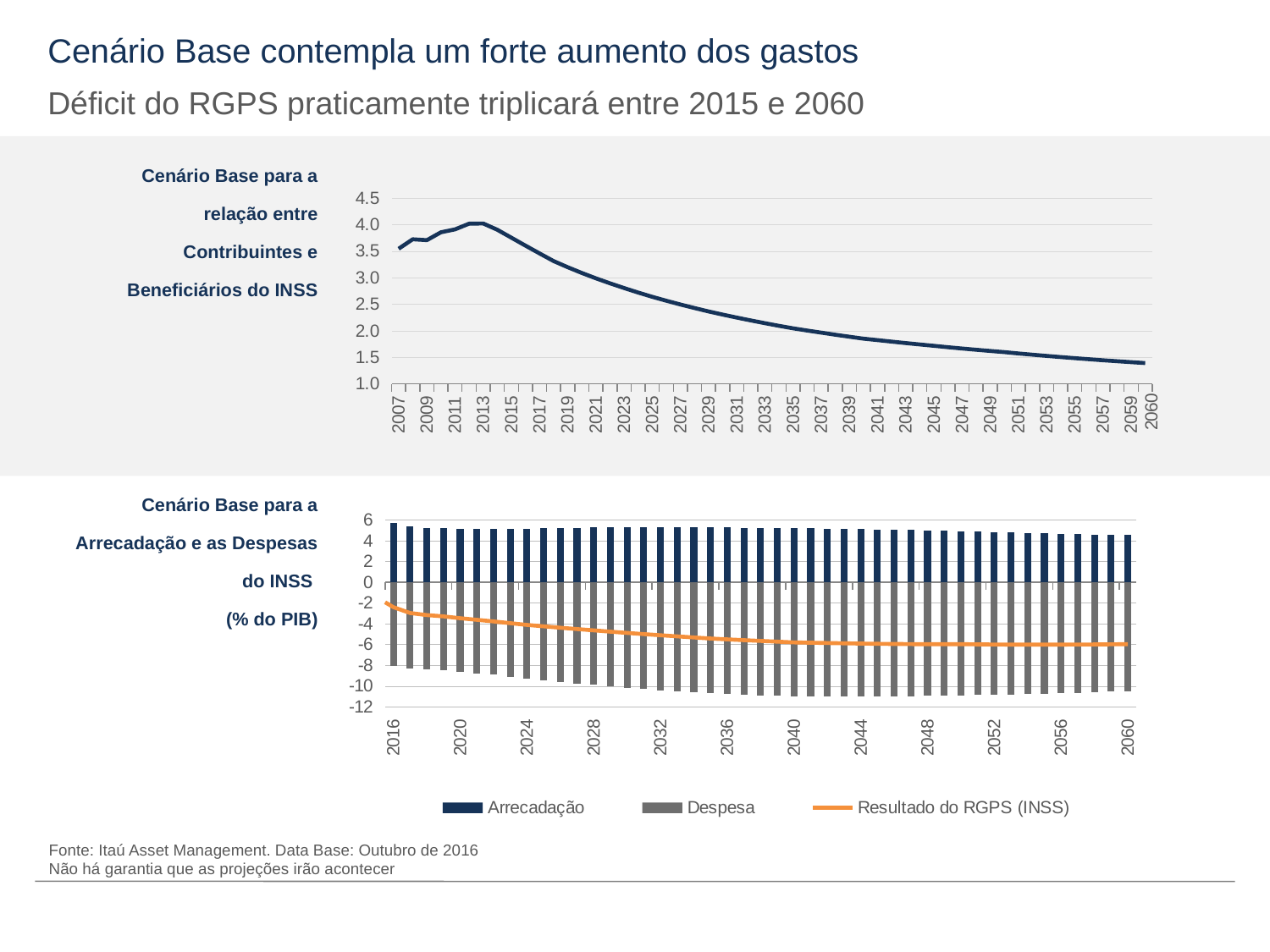
In the bottom chart (Arrecadação e as Despesas do INSS), is the Despesa value for 2060 greater or less than -8? less In the bottom chart (Arrecadação e as Despesas do INSS), which series is shown as an orange line? Resultado do RGPS (INSS) In the top chart (Cenário Base para a relação entre Contribuintes e Beneficiários do INSS), what kind of chart is it? Line chart In the bottom chart (Arrecadação e as Despesas do INSS), what unit is stated in the chart title? % do PIB In the top chart (relação entre Contribuintes e Beneficiários do INSS), is the value for 2007 larger or smaller than the value for 2060? Larger In the bottom chart (Arrecadação e as Despesas do INSS), is the Arrecadação value for 2016 greater or less than 4? greater In the top chart (relação entre Contribuintes e Beneficiários do INSS), is the value for 2060 greater or less than 2.0? less In the bottom chart (Arrecadação e as Despesas do INSS), does the Resultado do RGPS (INSS) line rise or fall from 2016 to 2060? Falls In the bottom chart (Arrecadação e as Despesas do INSS), how many series does the legend list? 3 In the top chart (relação entre Contribuintes e Beneficiários do INSS), does the line rise or fall between 2013 and 2060? Falls